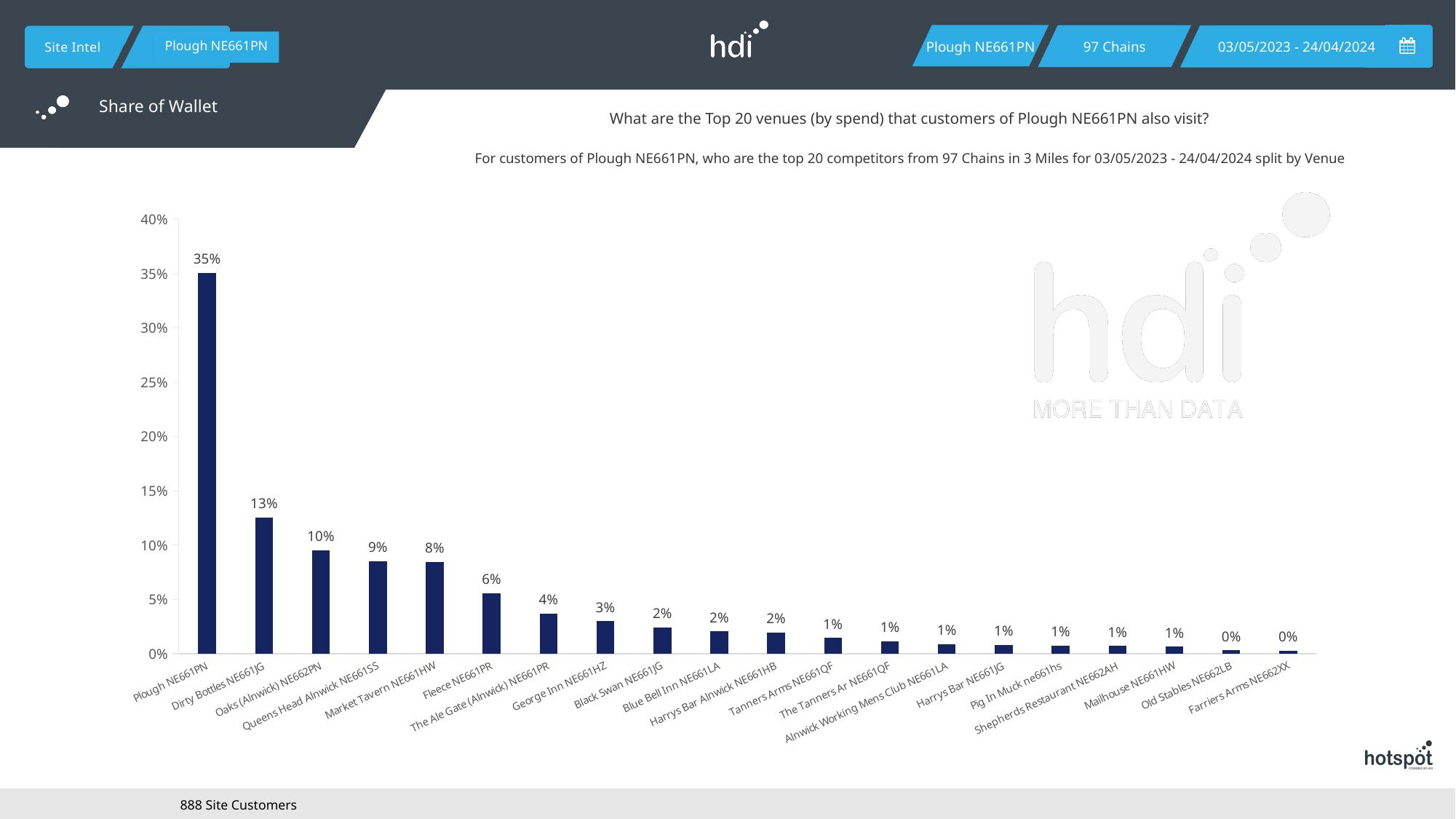
What is the value for Fleece NE661PR? 6% What is the value for Market Tavern NE661HW? 8% What is the value for Dirty Bottles NE661JG? 13% What is the value for George Inn NE661HZ? 3% Is the value for Dirty Bottles NE661JG greater or less than 10%? greater What is the value for Plough NE661PN? 35% Which venue has the highest value? Plough NE661PN What is the difference between the values for Plough NE661PN and Dirty Bottles NE661JG? 22 percentage points Which is larger, the value for Oaks (Alnwick) NE662PN or the value for Queens Head Alnwick NE661SS? Oaks (Alnwick) NE662PN Do the values rise or fall from left to right along the x axis? fall What kind of chart is shown on the slide? bar chart How many venues are shown on the chart? 20